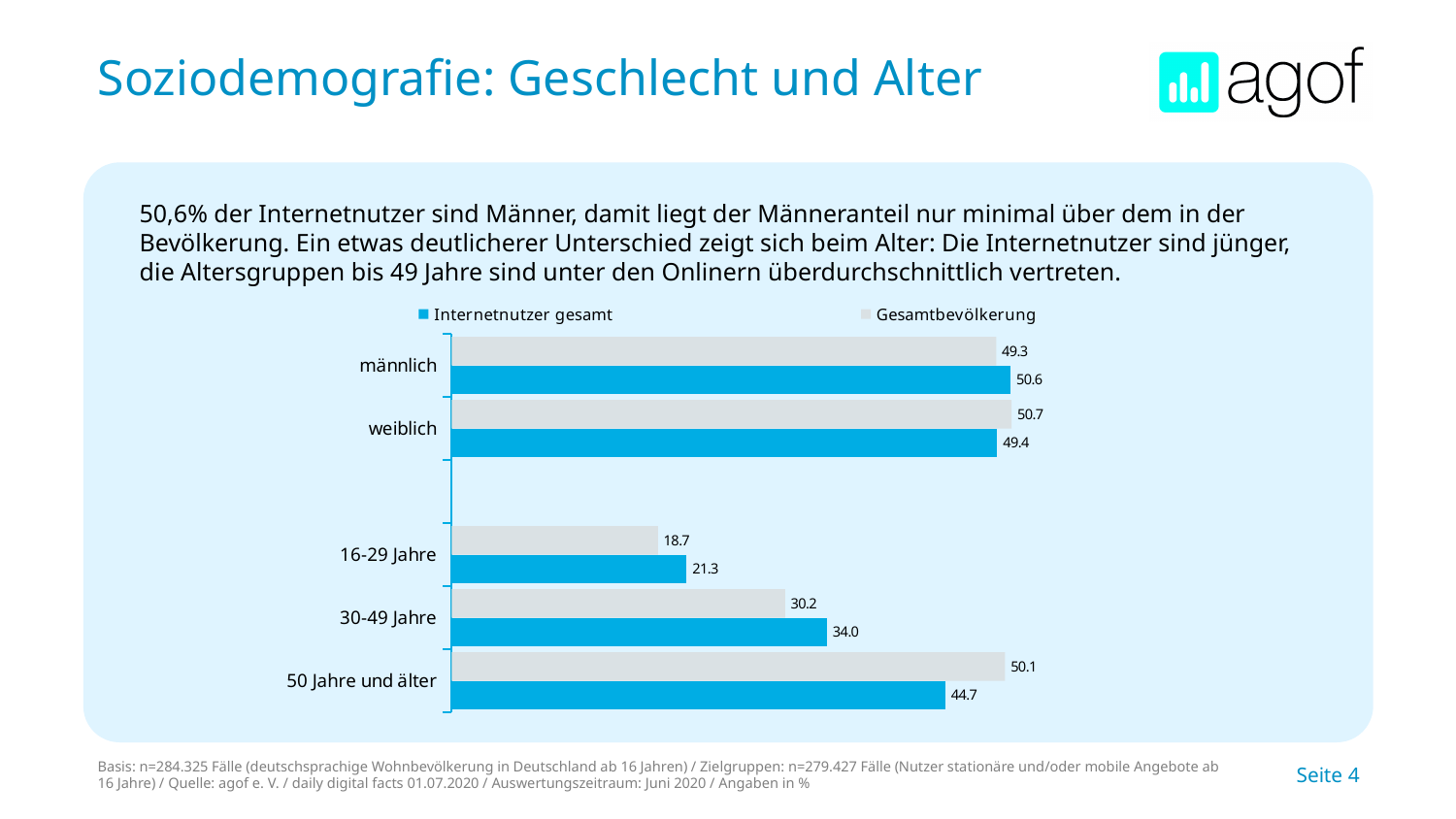
Among the age groups, which category has the highest value for Gesamtbevölkerung? 50 Jahre und älter How many categories are shown on the chart? 5 What kind of chart is shown on the slide? Bar chart In the 16-29 Jahre category, which series has the larger value, Internetnutzer gesamt or Gesamtbevölkerung? Internetnutzer gesamt What is the value for Internetnutzer gesamt in the männlich category? 50.6 What is the value for Internetnutzer gesamt in the 30-49 Jahre category? 34.0 What is the value for Gesamtbevölkerung in the 50 Jahre und älter category? 50.1 What is the difference between Gesamtbevölkerung and Internetnutzer gesamt in the 50 Jahre und älter category? 5.4 What is the value for Gesamtbevölkerung in the 16-29 Jahre category? 18.7 Among the age groups, which category has the lowest value for Internetnutzer gesamt? 16-29 Jahre What is the difference between Internetnutzer gesamt and Gesamtbevölkerung in the 30-49 Jahre category? 3.8 How many series does the legend list? 2